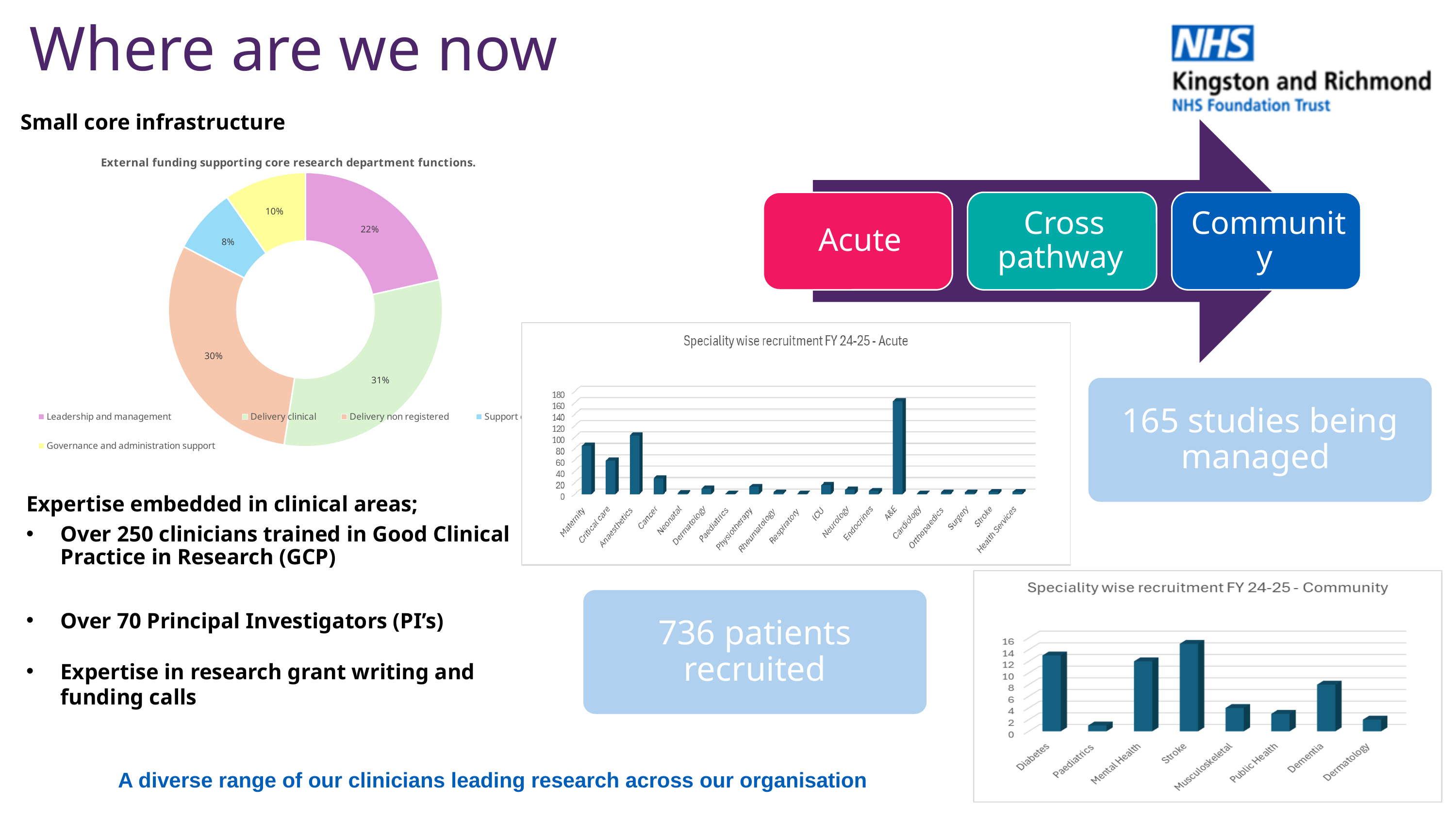
In the donut chart 'External funding supporting core research department functions', what is the difference in percentage points between Delivery clinical and Delivery non registered? 1 In the donut chart 'External funding supporting core research department functions', what percentage is shown for Leadership and management? 22% In the chart 'Speciality wise recruitment FY 24-25 - Acute', how many specialities are shown on the x axis? 19 In the chart 'Speciality wise recruitment FY 24-25 - Community', how many specialities are shown? 8 In the chart 'Speciality wise recruitment FY 24-25 - Community', which speciality has the lowest recruitment? Paediatrics In the chart 'Speciality wise recruitment FY 24-25 - Community', which speciality has the highest recruitment? Stroke In the chart 'Speciality wise recruitment FY 24-25 - Acute', is the value for A&E greater or less than 140? greater In the donut chart 'External funding supporting core research department functions', which category has the largest share? Delivery clinical In the chart 'Speciality wise recruitment FY 24-25 - Acute', which is larger, Maternity or Critical care? Maternity In the chart 'Speciality wise recruitment FY 24-25 - Acute', which speciality has the highest recruitment? A&E In the chart 'Speciality wise recruitment FY 24-25 - Acute', is the value for Critical care greater or less than 80? less In the donut chart 'External funding supporting core research department functions', what percentage is shown for Delivery clinical? 31%